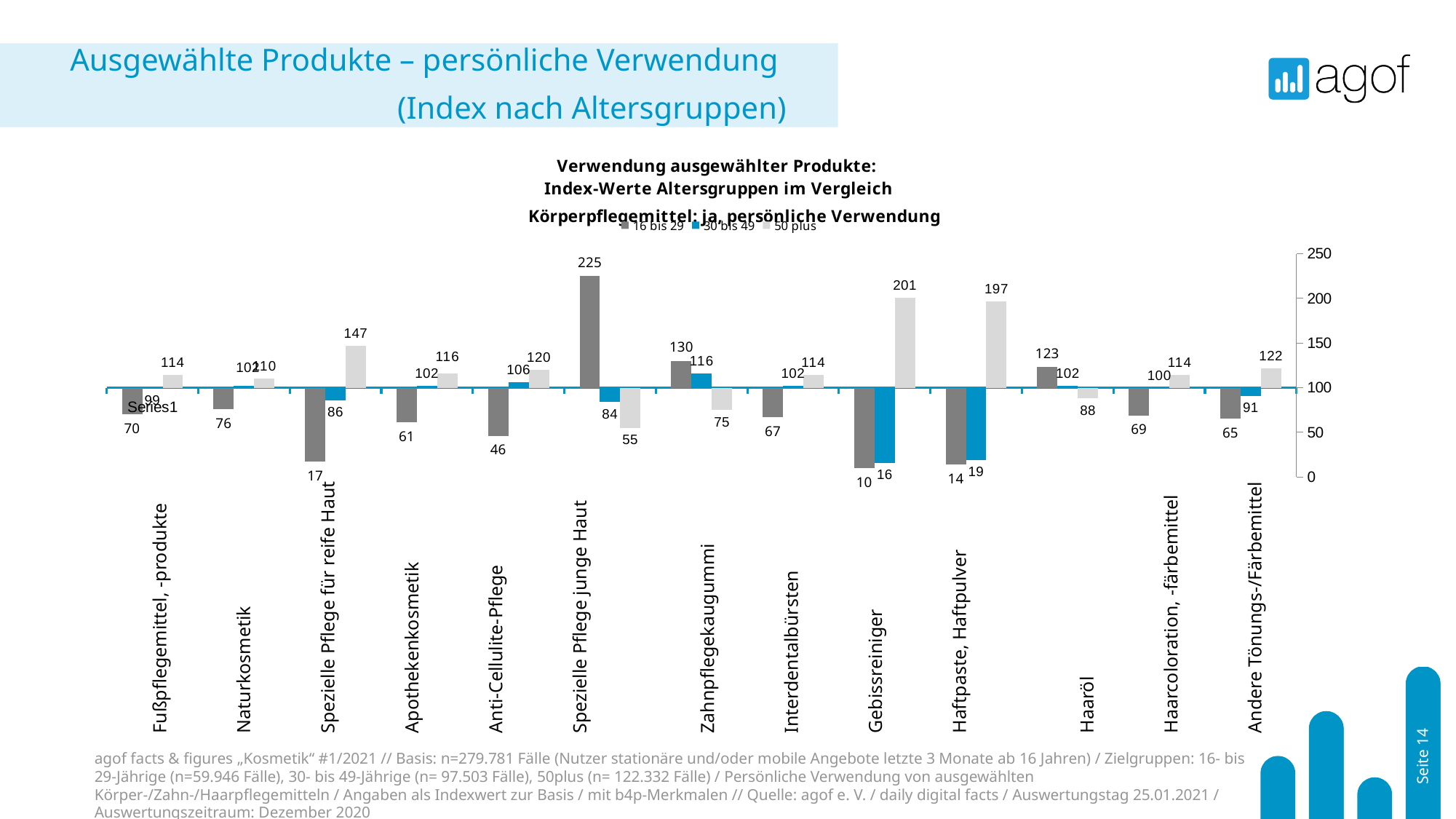
What is the difference between the 50 plus value and the 16 bis 29 value for Haftpaste, Haftpulver? 183 What is the value for the 30 bis 49 series for Spezielle Pflege für reife Haut? 86 What is the value for the 16 bis 29 series for Spezielle Pflege junge Haut? 225 How many product categories are shown on the x axis? 13 What is the value for the 50 plus series for Gebissreiniger? 201 What is the value for the 50 plus series for Haaröl? 88 Which category has the highest value in the 16 bis 29 series? Spezielle Pflege junge Haut How many series does the legend list? 3 What kind of chart is shown on the slide? Bar chart Which category has the lowest value in the 50 plus series? Spezielle Pflege junge Haut Which category has the lowest value in the 16 bis 29 series? Gebissreiniger Which is larger for Zahnpflegekaugummi: the 16 bis 29 value or the 50 plus value? 16 bis 29